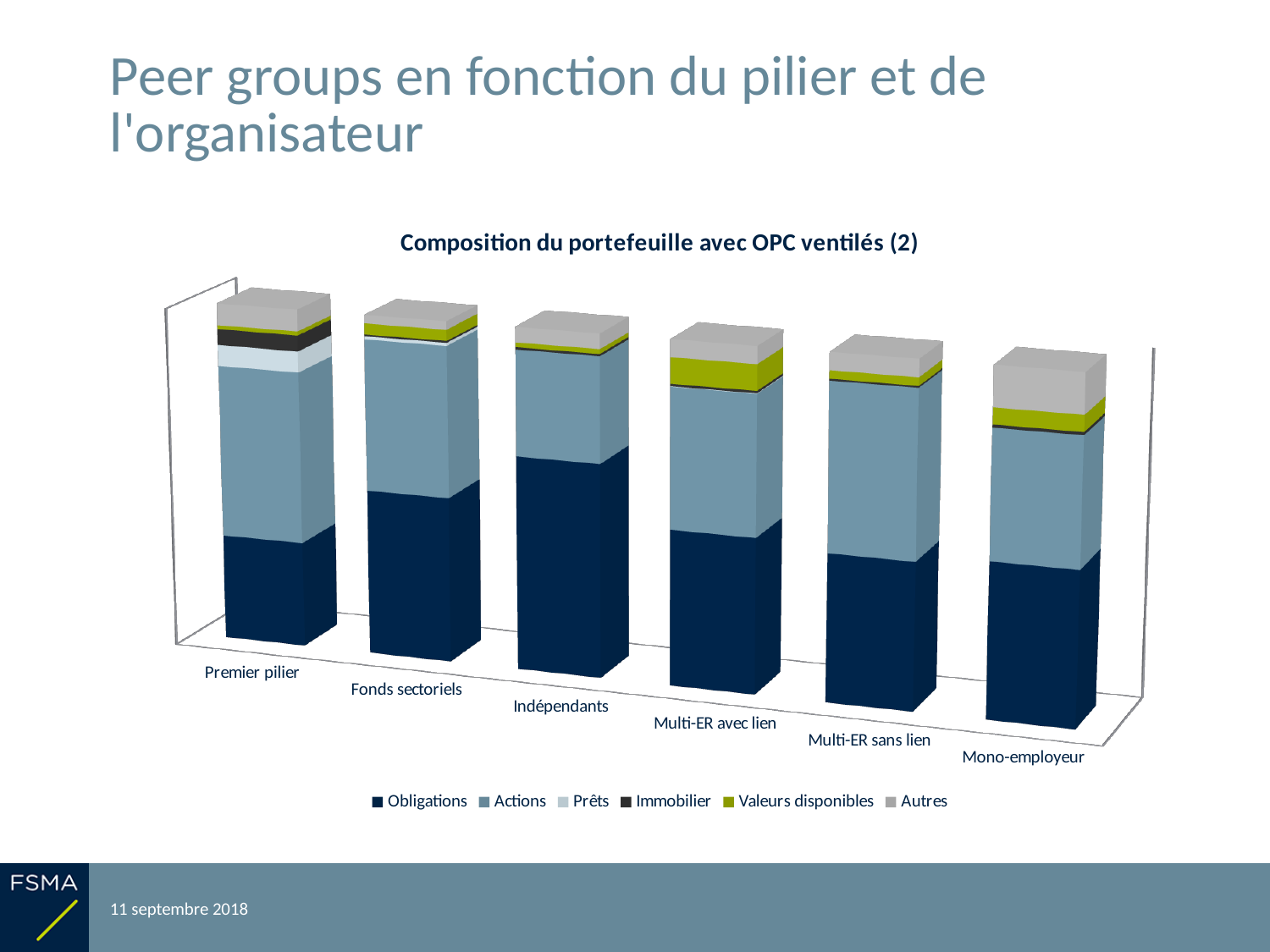
Which category is the last (rightmost) on the x axis of the chart? Mono-employeur Is the Valeurs disponibles segment larger for Multi-ER avec lien or for Fonds sectoriels? Multi-ER avec lien Is the Obligations segment larger for Mono-employeur or for Premier pilier? Mono-employeur What kind of chart is shown on the slide? Stacked bar chart Which series is shown in green in the chart's legend? Valeurs disponibles Which category has the smallest Obligations segment in the chart? Premier pilier Is the Actions segment larger for Premier pilier or for Mono-employeur? Premier pilier Which category shows a clearly visible Prêts segment in the chart? Premier pilier How many series does the chart's legend list? 6 How many categories (peer groups) are shown on the x axis of the chart? 6 What is the title of the chart? Composition du portefeuille avec OPC ventilés (2) Which category has the largest Immobilier segment in the chart? Premier pilier